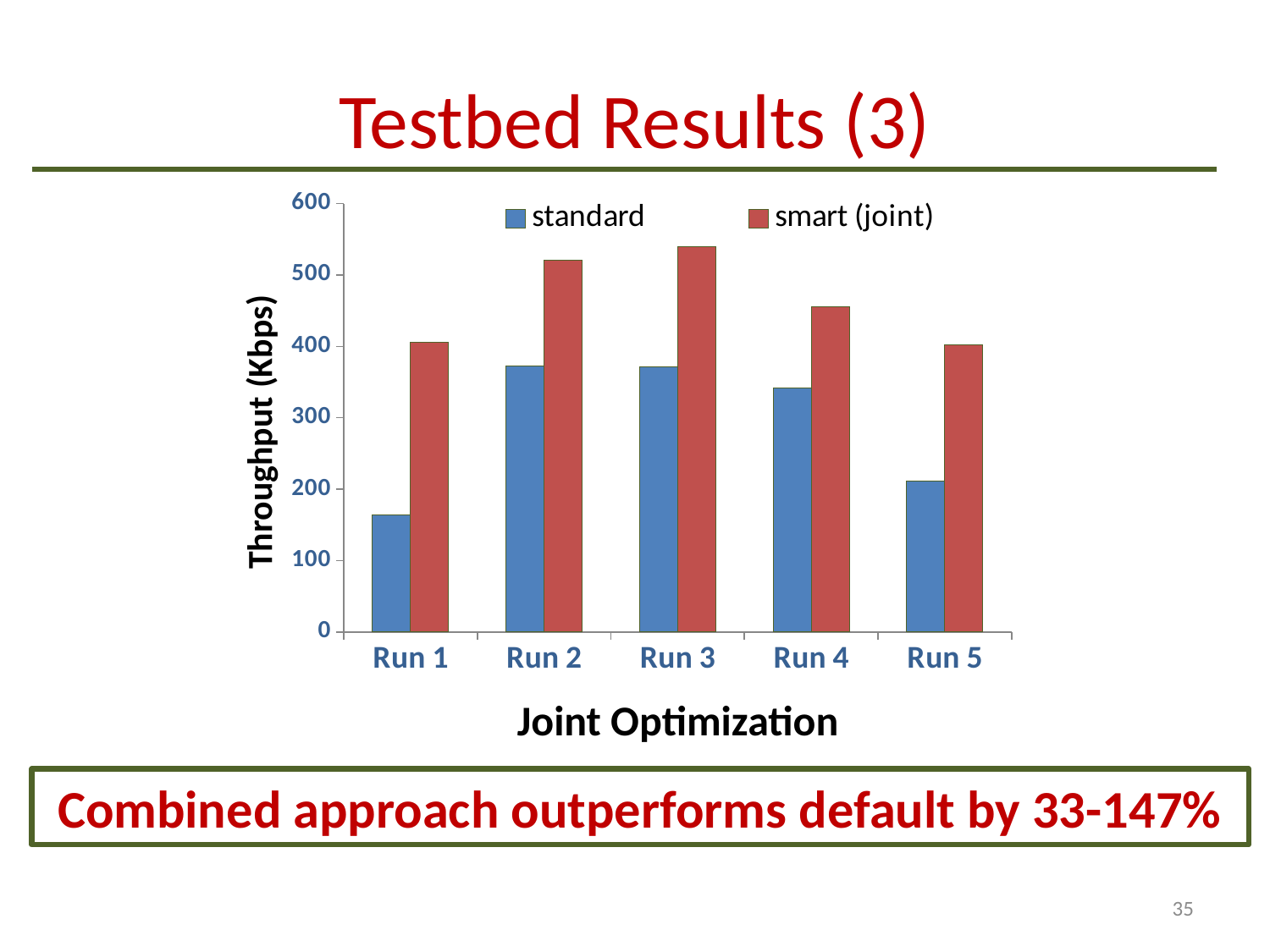
Is the smart (joint) throughput for Run 4 greater or less than 400 Kbps? greater Is the standard throughput for Run 1 greater or less than 200 Kbps? less Is the standard throughput for Run 4 greater or less than 400 Kbps? less For Run 5, which series has the larger throughput, standard or smart (joint)? smart (joint) Which run has the highest smart (joint) throughput? Run 3 How many series does the chart's legend list? 2 What kind of chart is shown on the slide? bar chart Which run has the lowest standard throughput? Run 1 What is the label of the vertical axis of the chart? Throughput (Kbps) Which colour represents the smart (joint) series in the chart? red How many runs are shown on the x axis of the chart? 5